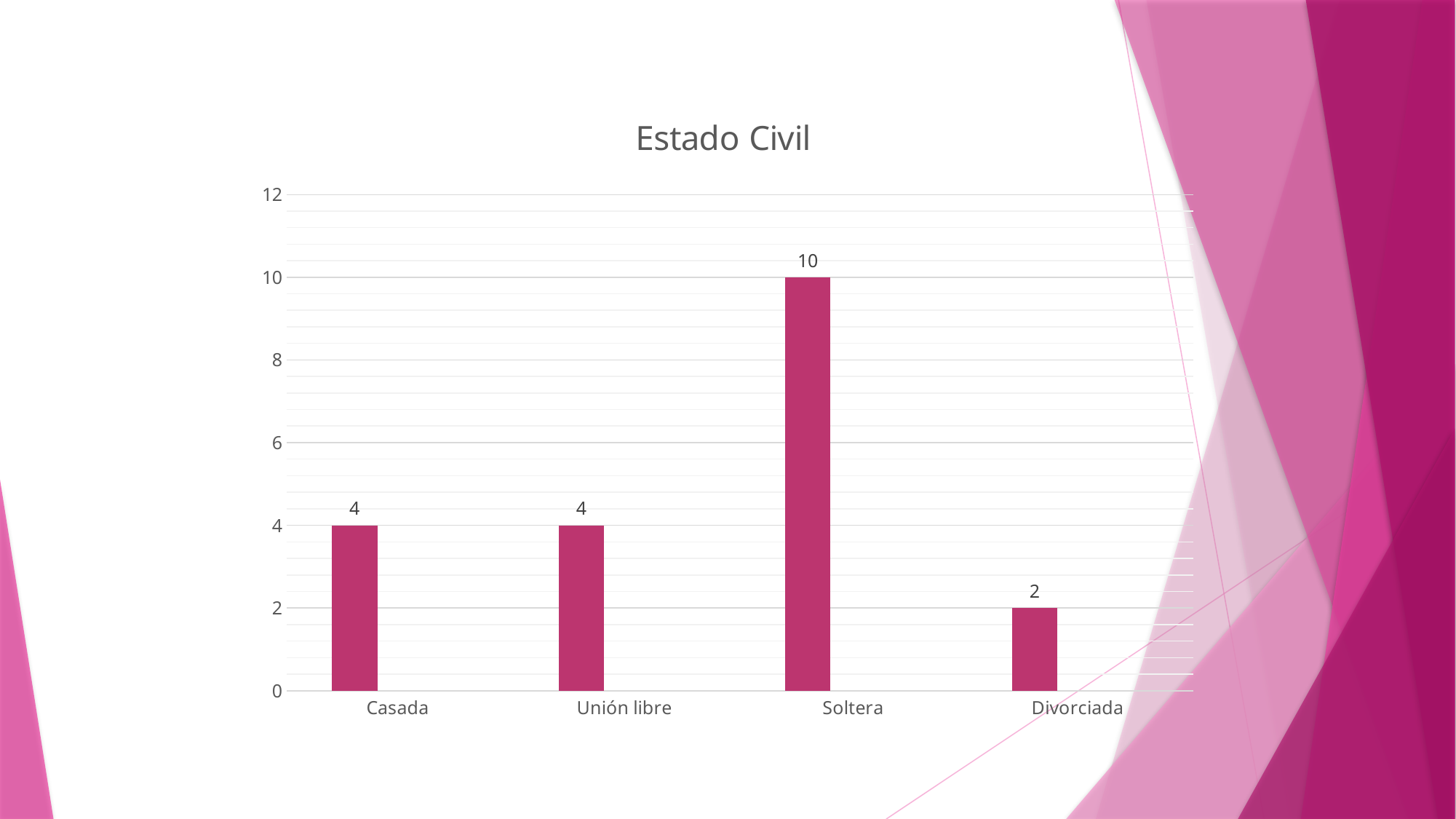
What is the difference between the values for Soltera and Divorciada? 8 What kind of chart is shown on the slide? bar chart How many categories are shown on the x axis? 4 Is the value for Soltera greater or less than 8? greater Which is larger, the value for Soltera or the value for Unión libre? Soltera What is the value for Unión libre? 4 Which category has the highest value? Soltera What is the value for Casada? 4 What is the value for Soltera? 10 What is the value for Divorciada? 2 Which category has the lowest value? Divorciada What is the difference between the values for Casada and Divorciada? 2